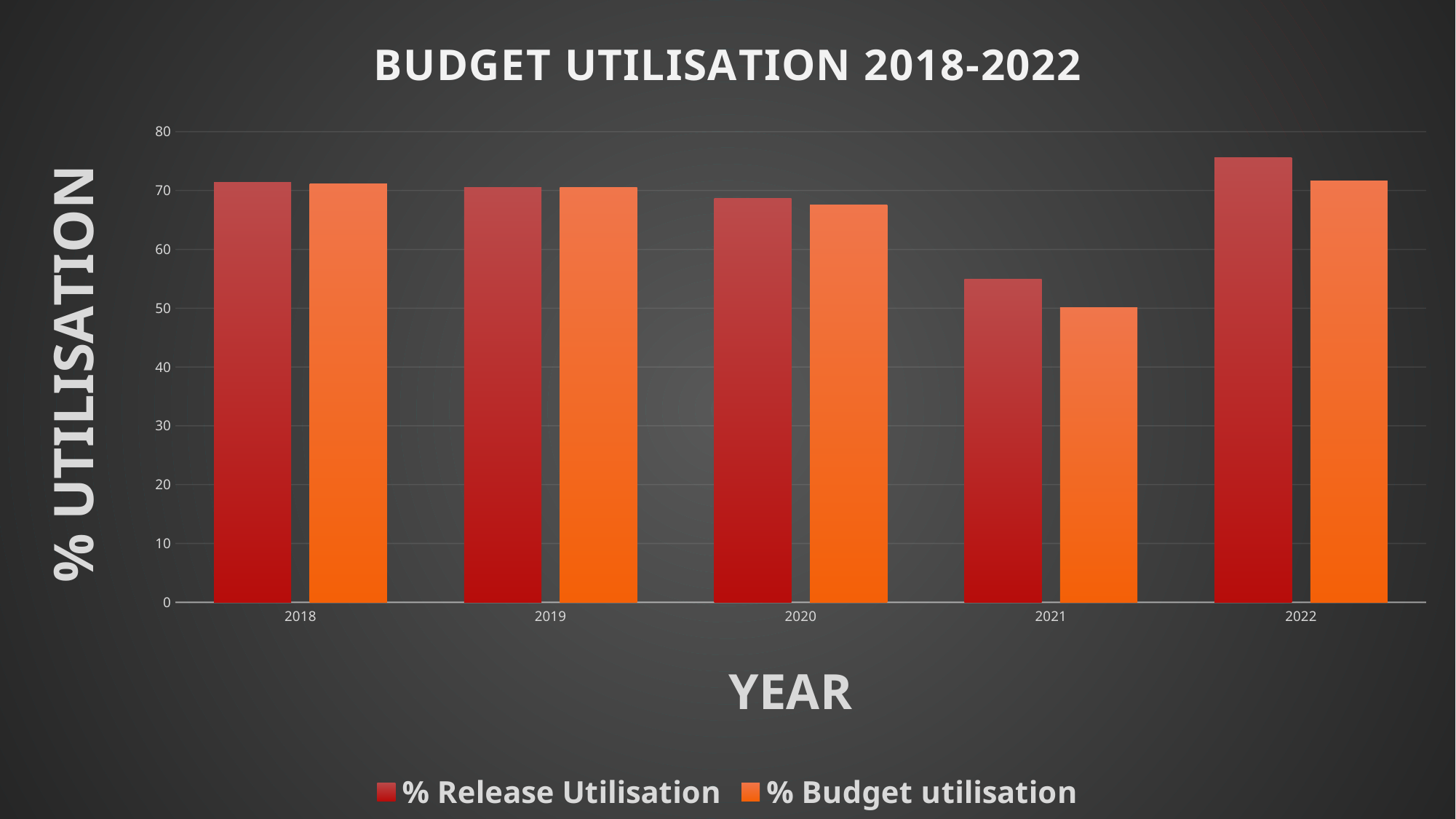
Does % Release Utilisation rise or fall from 2018 to 2021? fall In 2021, which is larger: % Release Utilisation or % Budget utilisation? % Release Utilisation How many series does the legend list? 2 Is the % Release Utilisation for 2022 greater or less than 70? greater How many years are shown on the x axis? 5 Which year has the highest % Release Utilisation? 2022 Is the % Release Utilisation for 2021 greater or less than 60? less Which year has the lowest % Budget utilisation? 2021 Is the % Budget utilisation for 2020 greater or less than 70? less What kind of chart is shown on the slide? bar chart Which year has the lowest % Release Utilisation? 2021 What is the title of the chart? BUDGET UTILISATION 2018-2022